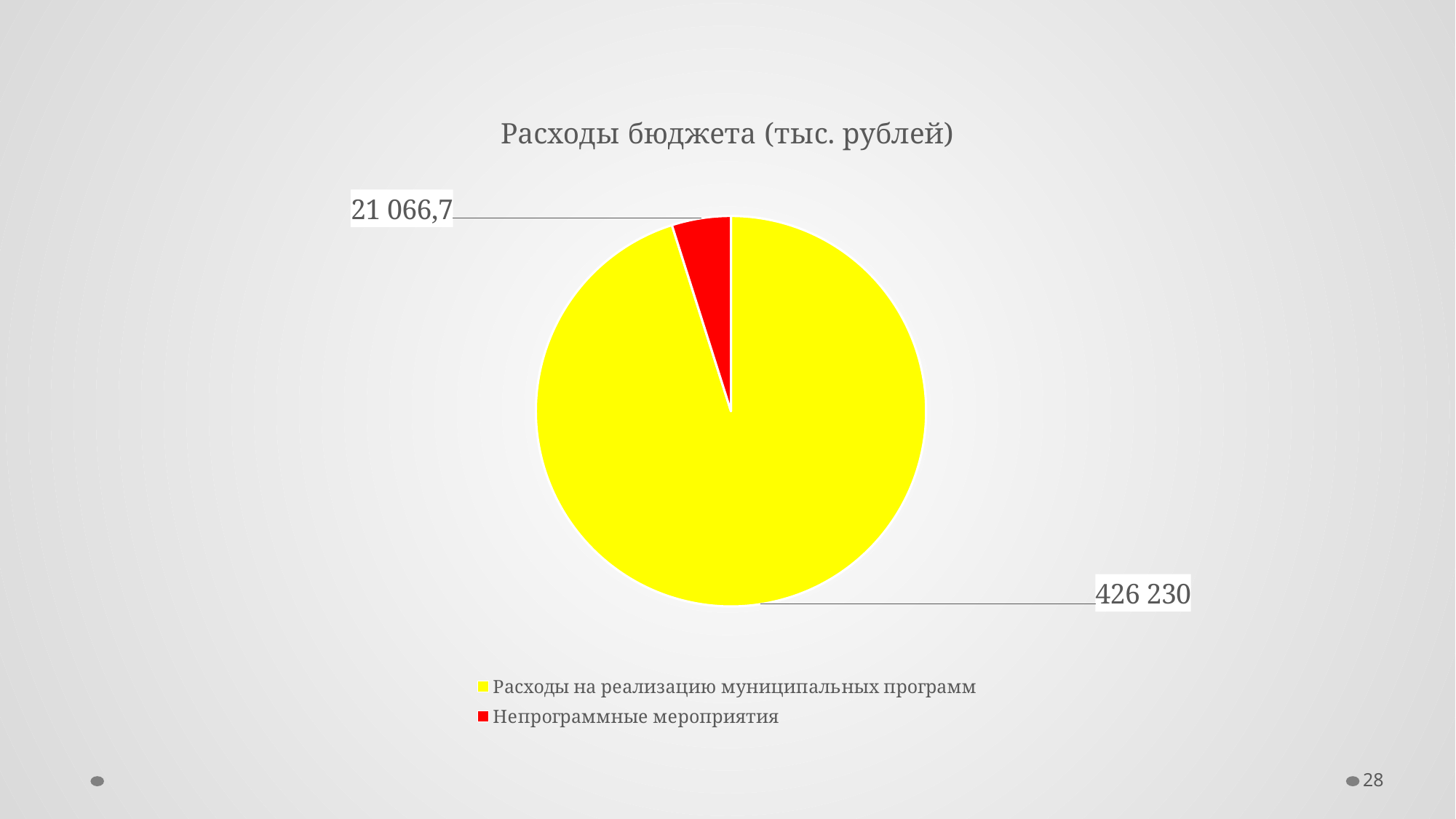
Which is larger: Расходы на реализацию муниципальных программ or Непрограммные мероприятия? Расходы на реализацию муниципальных программ What is the value for Расходы на реализацию муниципальных программ? 426 230 Which category has the smallest slice of the pie? Непрограммные мероприятия Which category has the largest slice of the pie? Расходы на реализацию муниципальных программ How many entries does the legend list? 2 What is the title of the chart? Расходы бюджета (тыс. рублей) What kind of chart is shown on the slide? pie chart How many categories does the pie chart have? 2 What is the total of the two values shown in the pie chart? 447 296,7 What colour is the slice for Непрограммные мероприятия? red What is the difference between the value for Расходы на реализацию муниципальных программ and the value for Непрограммные мероприятия? 405 163,3 What is the value for Непрограммные мероприятия? 21 066,7